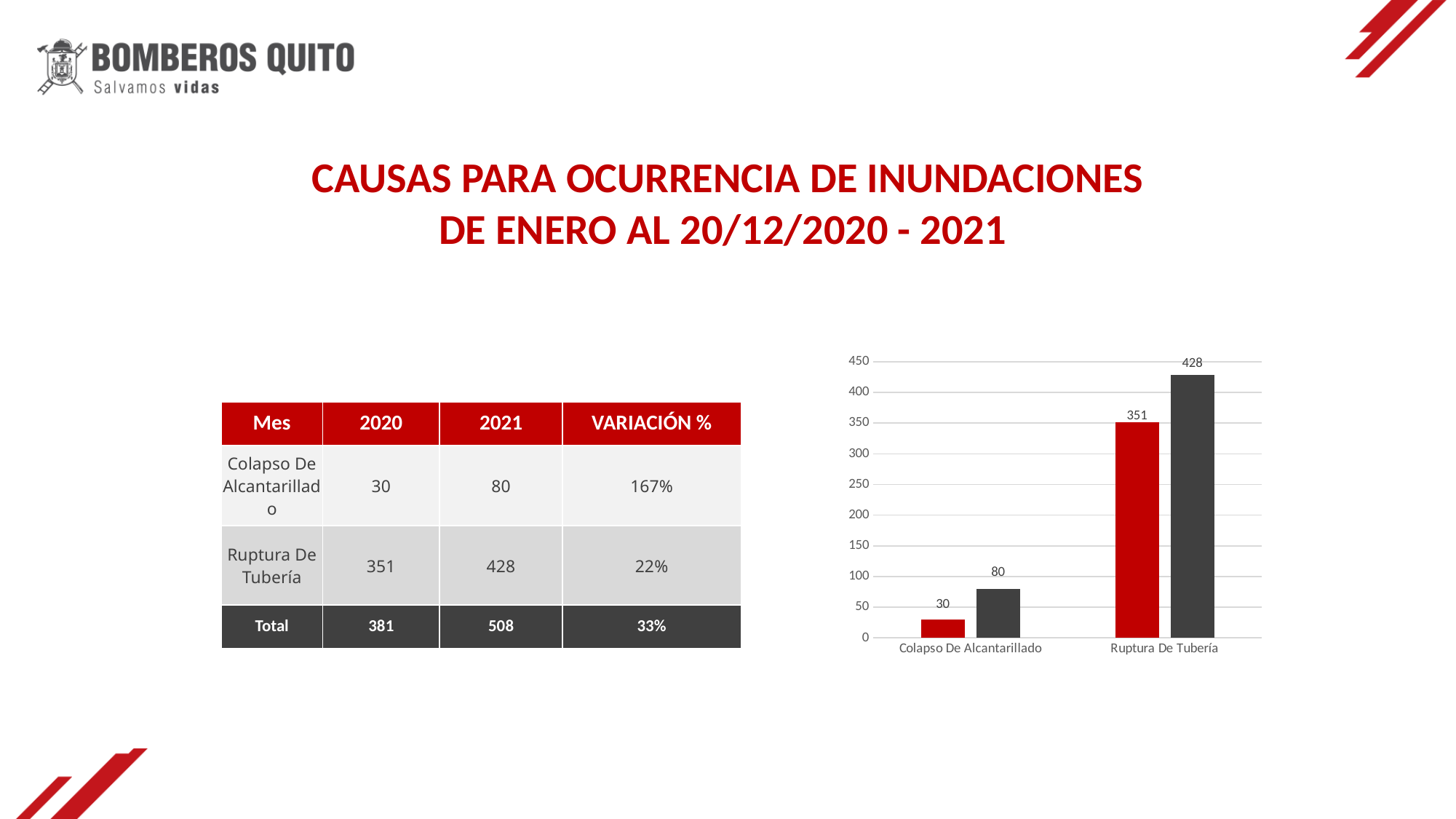
Which category has the tallest bar in the chart? Ruptura De Tubería What is the difference between the dark grey bar and the red bar for Ruptura De Tubería? 77 What is the difference between the dark grey bar and the red bar for Colapso De Alcantarillado? 50 What is the value of the dark grey bar for Ruptura De Tubería? 428 What is the value of the red bar for Colapso De Alcantarillado? 30 What is the value of the red bar for Ruptura De Tubería? 351 Which bar in the chart has the lowest value? The red bar for Colapso De Alcantarillado (30) What kind of chart is shown on the slide? Bar chart For Ruptura De Tubería, which is larger: the red bar or the dark grey bar? The dark grey bar Is the value of the red bar for Ruptura De Tubería greater or less than 300? greater What is the value of the dark grey bar for Colapso De Alcantarillado? 80 How many categories are shown on the x axis of the chart? 2